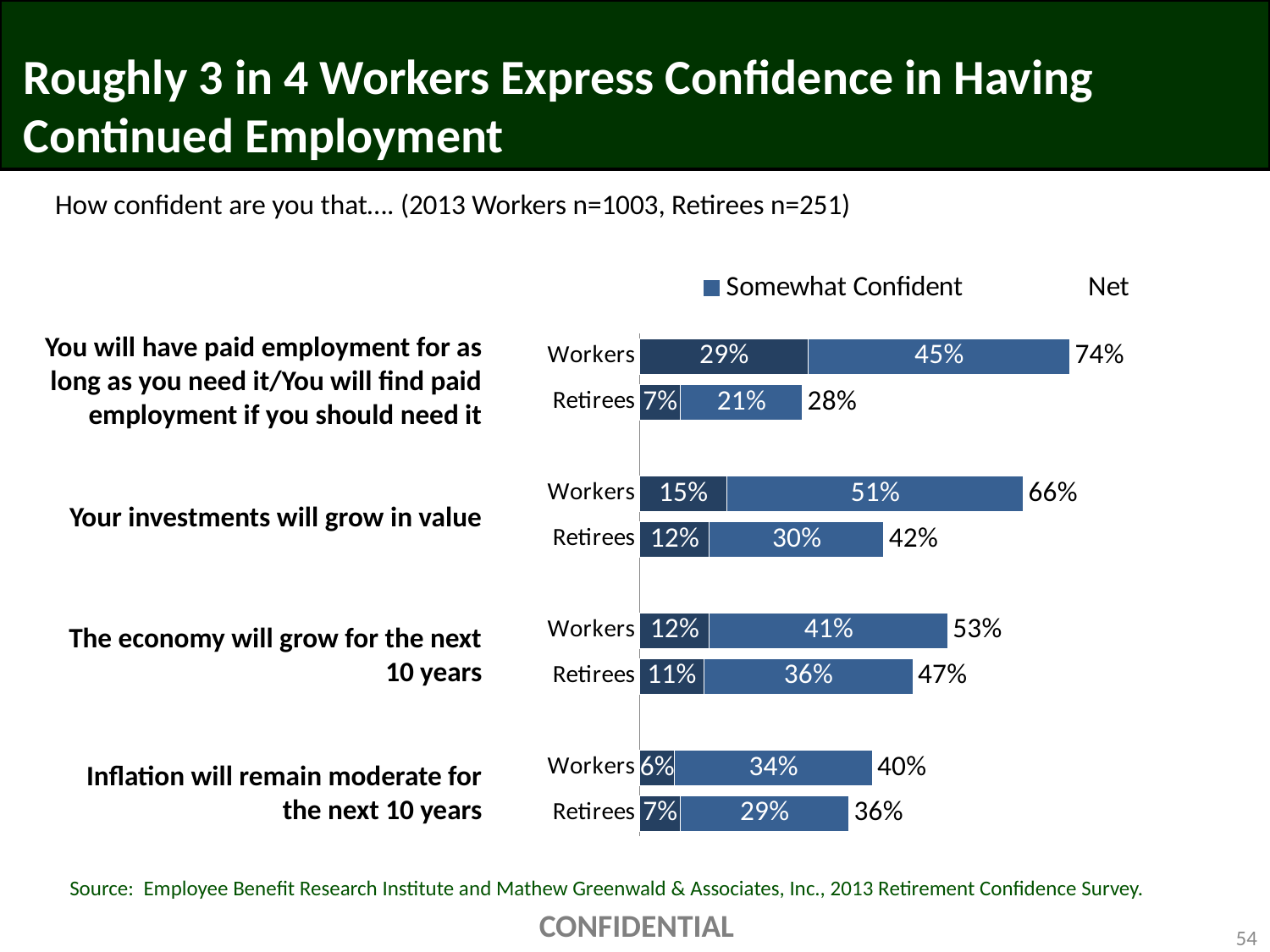
Which bar has the lowest Net value? Retirees, paid employment (28%) How many bars are plotted in the chart? 8 What kind of chart is shown on the slide? Stacked horizontal bar chart For "The economy will grow for the next 10 years", which group has the larger Net value, Workers or Retirees? Workers Among the Workers bars, which statement has the highest Somewhat Confident value? Your investments will grow in value (51%) What is the difference between the Workers and Retirees Net values for "You will have paid employment for as long as you need it"? 46 percentage points What is the Somewhat Confident value for Workers on "Inflation will remain moderate for the next 10 years"? 34% What is the Net value for Retirees on "Inflation will remain moderate for the next 10 years"? 36% What is the Somewhat Confident value for Retirees on "Your investments will grow in value"? 30% What is the Net value for Workers on "You will have paid employment for as long as you need it/You will find paid employment if you should need it"? 74% What is the total (Net) of the stacked bar for Workers on "Your investments will grow in value"? 66% Which bar has the highest Net value? Workers, paid employment (74%)